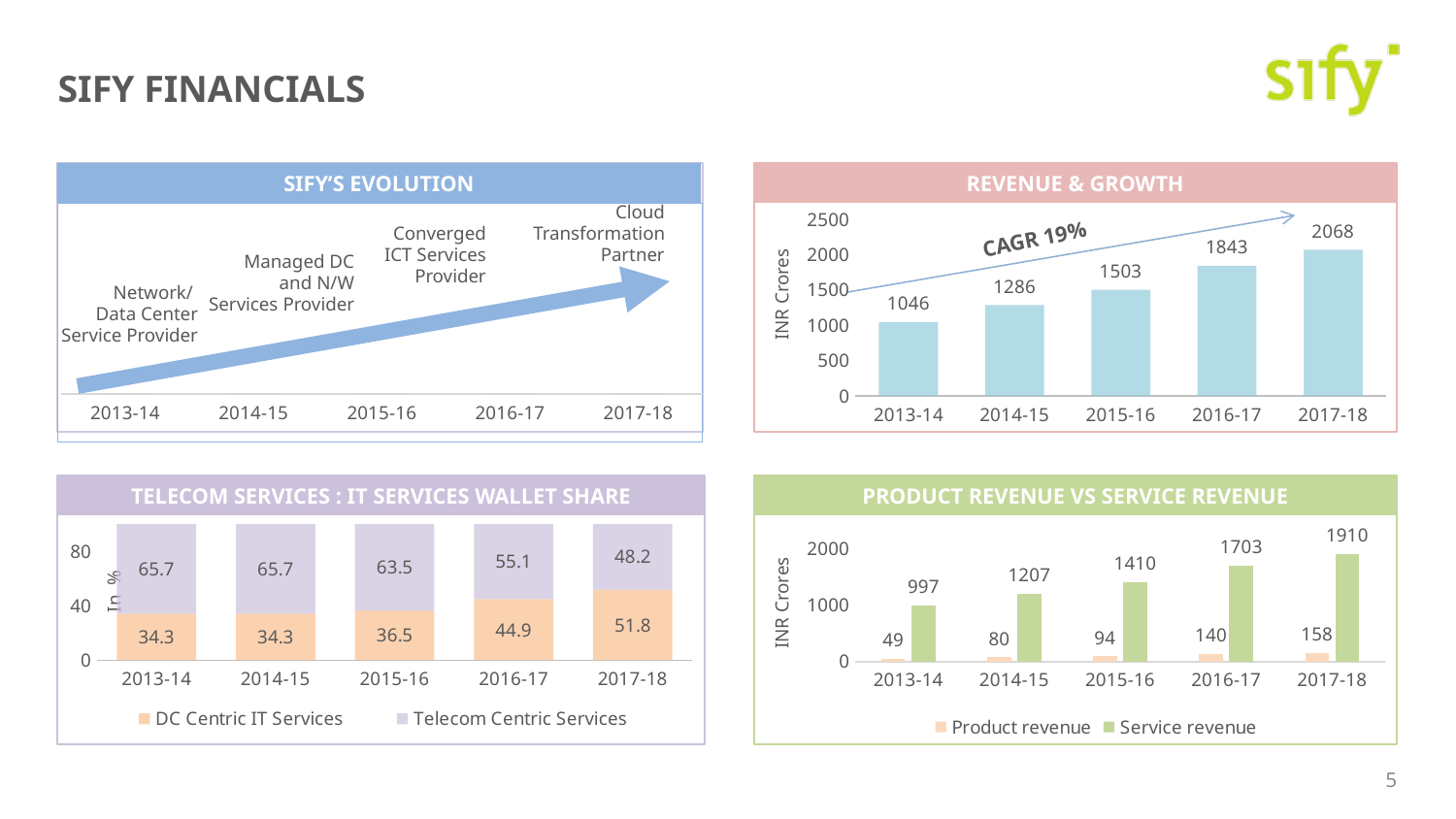
In the Telecom Services : IT Services Wallet Share chart, what is the total of the stacked bar for 2017-18? 100 In the Revenue & Growth chart, what CAGR is shown? 19% In the Revenue & Growth chart, which year has the highest revenue? 2017-18 In the Revenue & Growth chart, what is the difference in revenue between 2017-18 and 2013-14? 1022 In the Revenue & Growth chart, do the values rise or fall from 2013-14 to 2017-18? rise In the Telecom Services : IT Services Wallet Share chart, which year has the lowest value for DC Centric IT Services? 2013-14 and 2014-15 In the Product Revenue vs Service Revenue chart, what is the service revenue for 2016-17? 1703 In the Revenue & Growth chart, what is the revenue for 2015-16? 1503 In the Product Revenue vs Service Revenue chart, what is the difference between service revenue and product revenue in 2017-18? 1752 How many series does the legend of the Product Revenue vs Service Revenue chart list? 2 In the Telecom Services : IT Services Wallet Share chart, what is the value for Telecom Centric Services in 2016-17? 55.1 What kind of chart is the Product Revenue vs Service Revenue chart? bar chart